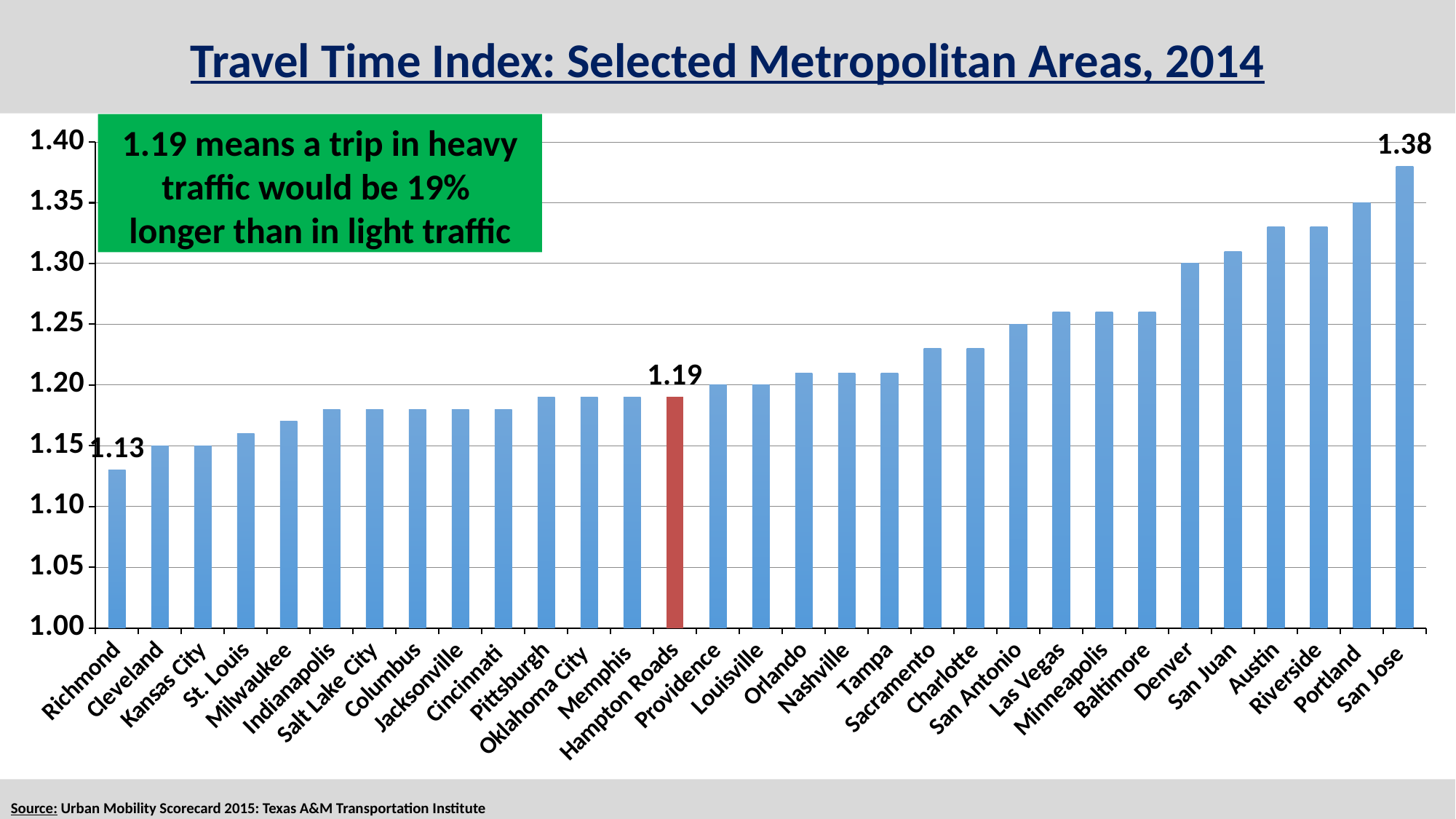
What is the Travel Time Index value for Richmond? 1.13 Is the value for Cleveland greater or less than 1.20? less What is the Travel Time Index value for Hampton Roads? 1.19 Which metropolitan area has the lowest Travel Time Index? Richmond What is the Travel Time Index value for San Jose? 1.38 Is the value for Portland greater or less than 1.30? greater Which metropolitan area's bar is highlighted in red? Hampton Roads What kind of chart is shown on the slide? Bar chart How many metropolitan areas are shown on the chart? 31 What is the difference between the Travel Time Index of San Jose and Richmond? 0.25 Which metropolitan area has the highest Travel Time Index? San Jose Which has a higher Travel Time Index, Denver or Tampa? Denver